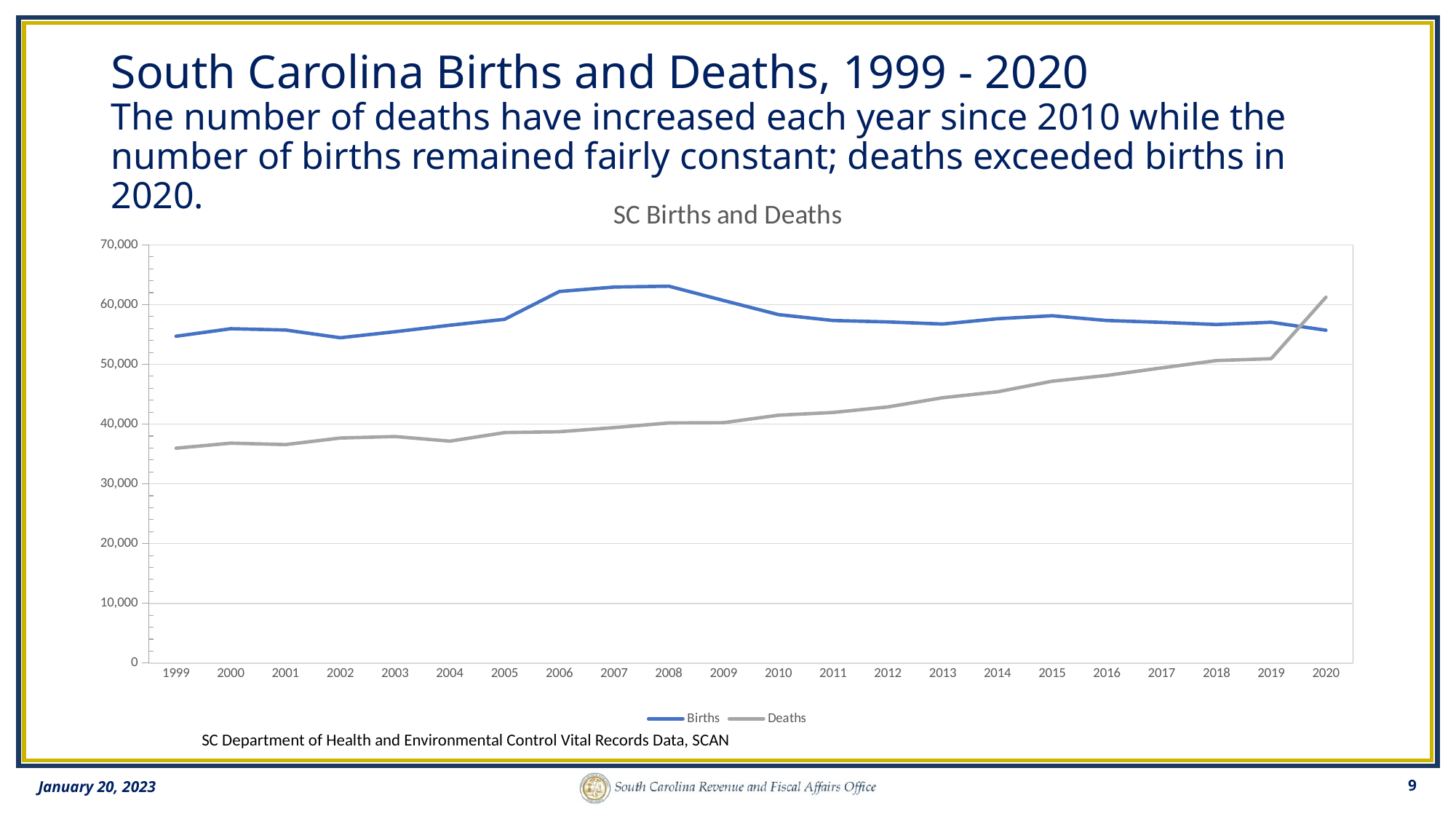
In 2020, which series has the larger value, Births or Deaths? Deaths What colour is the Births line in the chart? Blue In 2010, which series has the larger value, Births or Deaths? Births Is the value for Deaths in 2015 greater or less than 50,000? less What kind of chart is shown on the slide? Line chart Is the value for Births in 2008 greater or less than 60,000? greater Is the value for Deaths in 2020 greater or less than 60,000? greater In which year is the Deaths series at its highest? 2020 How many years are plotted along the x axis of the SC Births and Deaths chart? 22 How many series does the legend of the SC Births and Deaths chart list? 2 Does the Deaths series generally rise or fall from 1999 to 2020? Rise